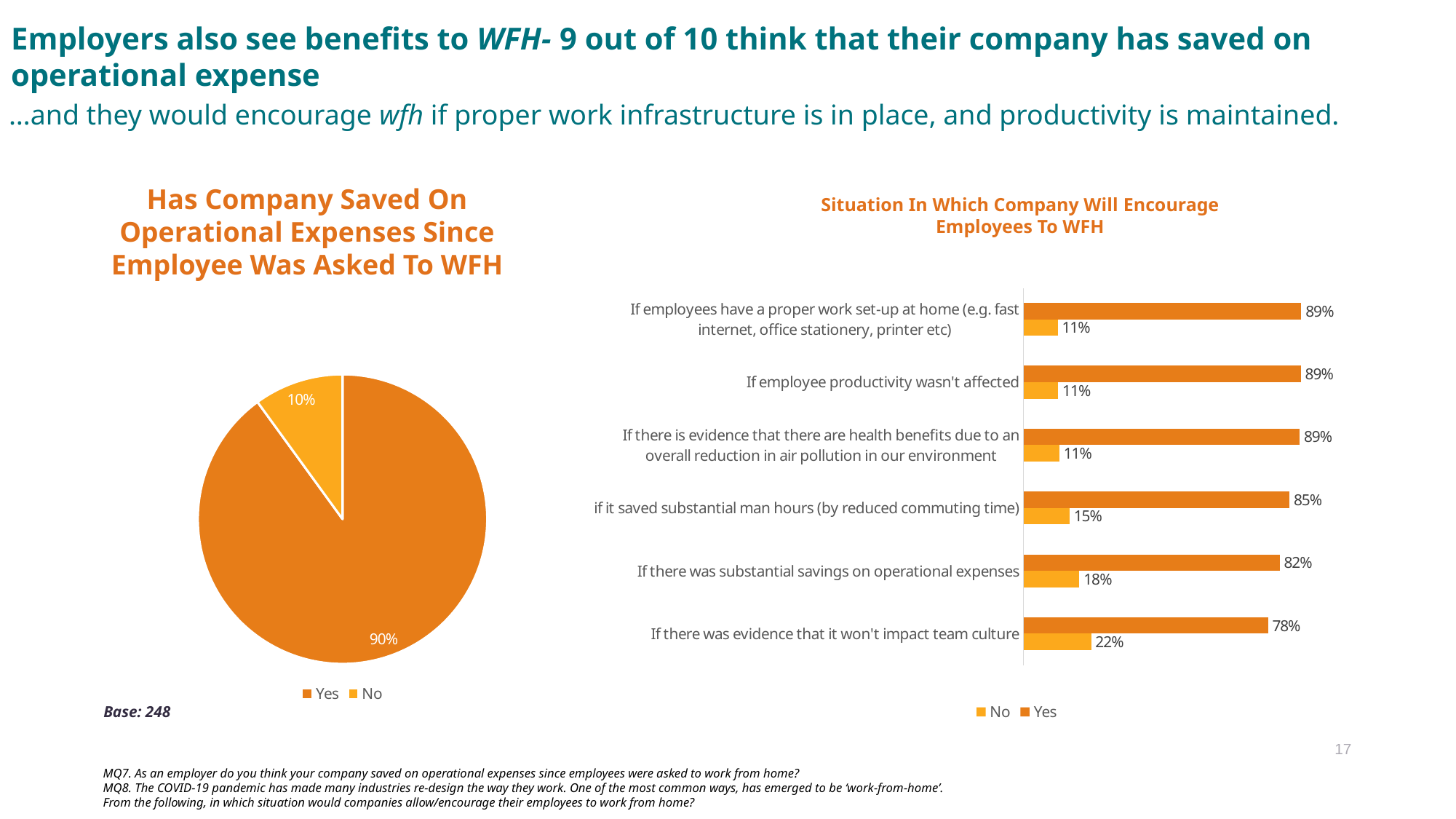
In the chart 'Situation In Which Company Will Encourage Employees To WFH', what is the No value for 'If there was substantial savings on operational expenses'? 18% In the pie chart 'Has Company Saved On Operational Expenses Since Employee Was Asked To WFH', what share of respondents answered No? 10% In the chart 'Situation In Which Company Will Encourage Employees To WFH', what is the difference between the Yes values for 'If employee productivity wasn't affected' and 'If there was substantial savings on operational expenses'? 7% What kind of chart is the right chart, 'Situation In Which Company Will Encourage Employees To WFH'? Bar chart In the chart 'Situation In Which Company Will Encourage Employees To WFH', how many situations are listed? 6 What kind of chart is the left chart, 'Has Company Saved On Operational Expenses Since Employee Was Asked To WFH'? Pie chart In the pie chart 'Has Company Saved On Operational Expenses Since Employee Was Asked To WFH', what share of respondents answered Yes? 90% In the chart 'Situation In Which Company Will Encourage Employees To WFH', which situation has the highest No value? If there was evidence that it won't impact team culture How many series does the legend of the chart 'Situation In Which Company Will Encourage Employees To WFH' list? 2 In the chart 'Situation In Which Company Will Encourage Employees To WFH', what is the Yes value for 'If there was evidence that it won't impact team culture'? 78% In the chart 'Situation In Which Company Will Encourage Employees To WFH', which situation has the lowest Yes value? If there was evidence that it won't impact team culture In the chart 'Situation In Which Company Will Encourage Employees To WFH', what is the Yes value for 'if it saved substantial man hours (by reduced commuting time)'? 85%